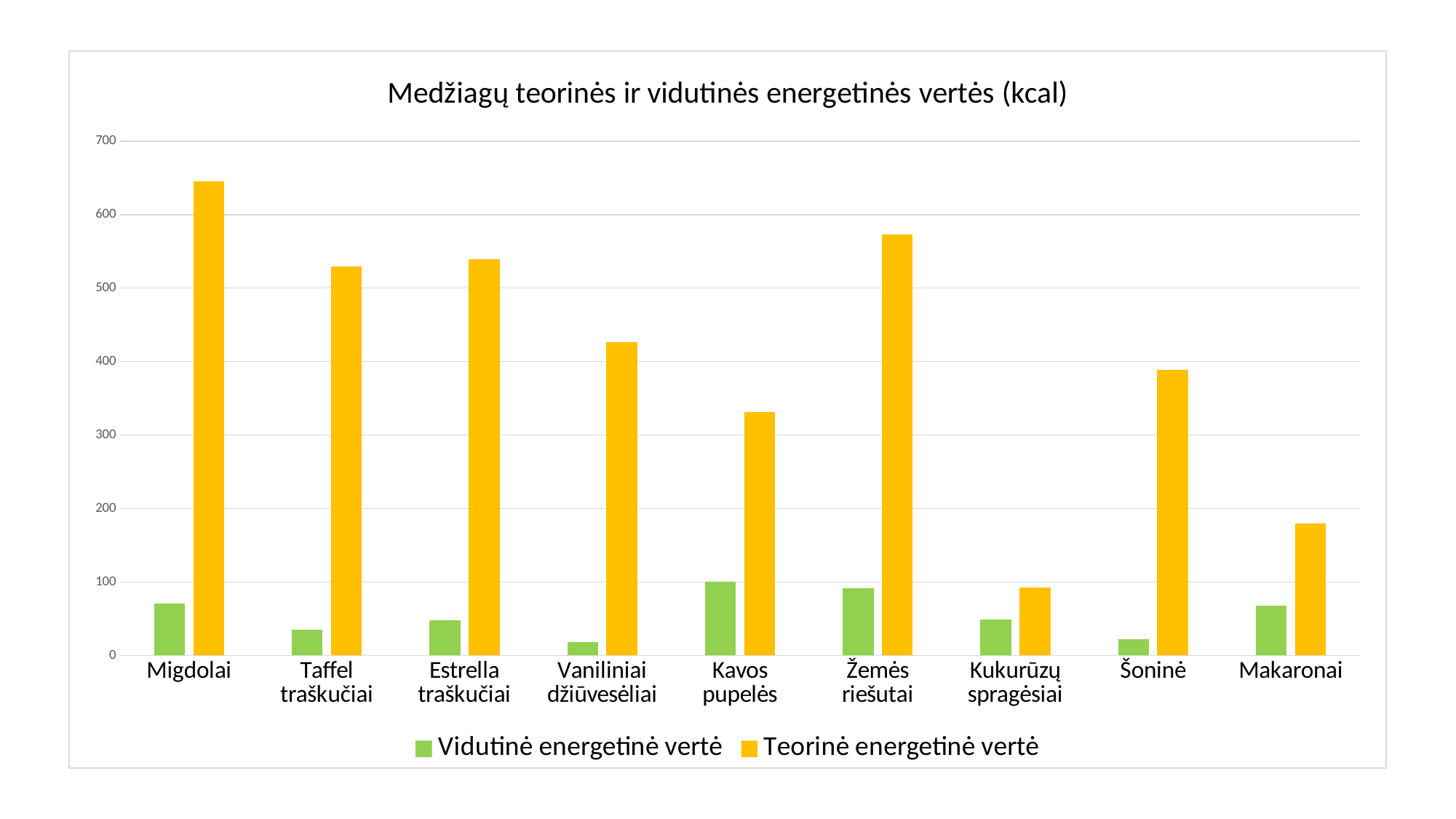
Which is larger, the Vidutinė energetinė vertė for Migdolai or for Taffel traškučiai? Migdolai What kind of chart is shown on the slide? bar chart Is the Teorinė energetinė vertė for Migdolai greater or less than 600? greater Is the Teorinė energetinė vertė for Šoninė greater or less than 400? less How many series does the legend list? 2 Which is larger, the Teorinė energetinė vertė for Žemės riešutai or for Estrella traškučiai? Žemės riešutai What is the title of the chart? Medžiagų teorinės ir vidutinės energetinės vertės (kcal) Which category has the lowest Teorinė energetinė vertė? Kukurūzų spragėsiai Is the Teorinė energetinė vertė for Makaronai greater or less than 200? less How many categories are shown on the x axis? 9 Which category has the highest Teorinė energetinė vertė? Migdolai